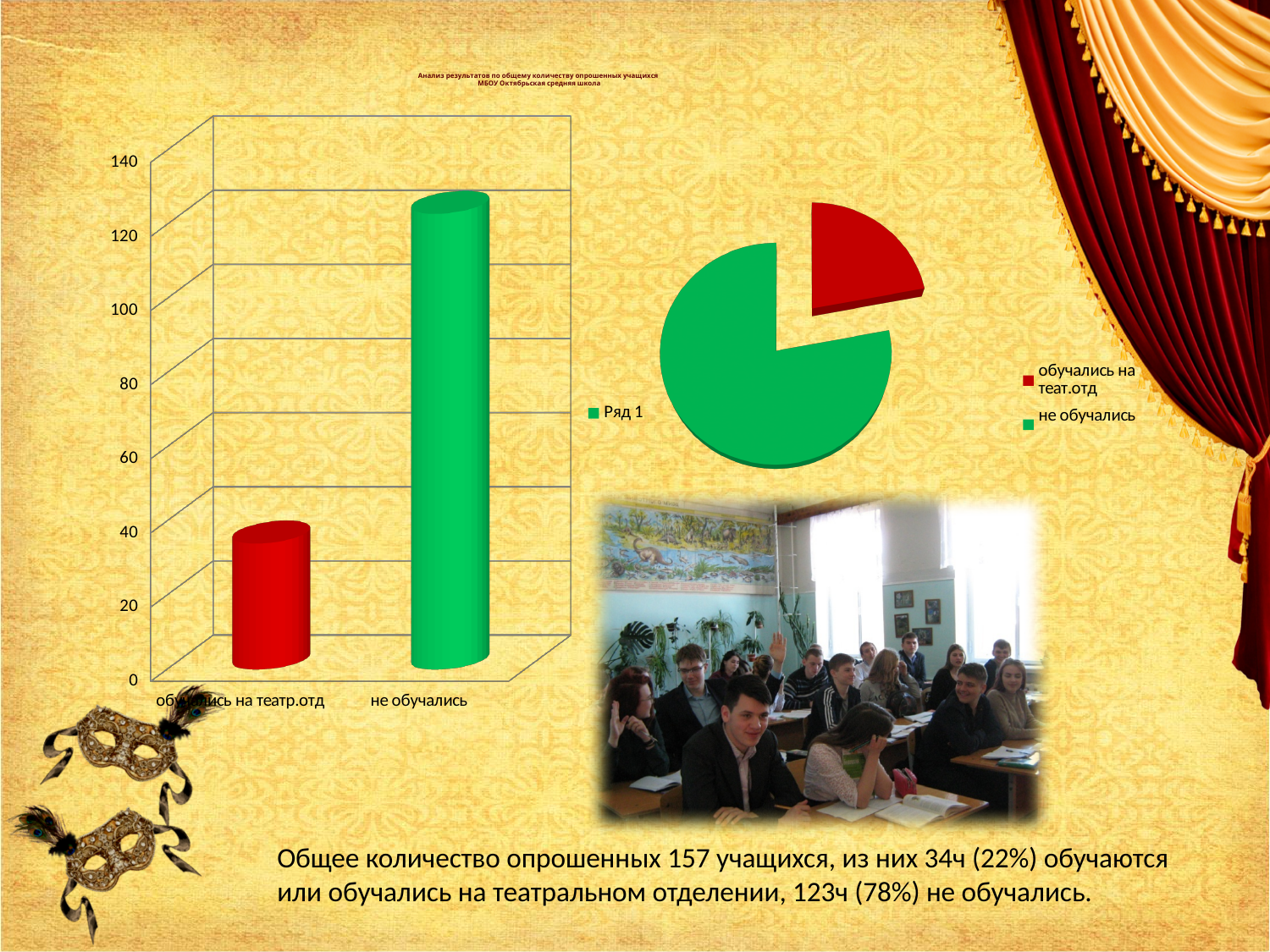
In the bar chart on the left, is the value for не обучались greater or less than 100? greater How many series does the legend of the bar chart on the left list? 1 How many entries does the legend of the pie chart list? 2 In the bar chart on the left, is the value for обучались на театр.отд greater or less than 40? less In the bar chart on the left, which category has the lowest value? обучались на театр.отд How many categories are shown in the bar chart on the left? 2 In the bar chart on the left, which category has the highest value? не обучались What kind of chart is the chart in the upper right of the slide? pie chart In the pie chart, which slice is larger: обучались на теат.отд or не обучались? не обучались What kind of chart is the chart on the left of the slide? bar chart In the bar chart on the left, is the value for обучались на театр.отд greater or less than 20? greater What is the name of the series in the legend of the bar chart on the left? Ряд 1